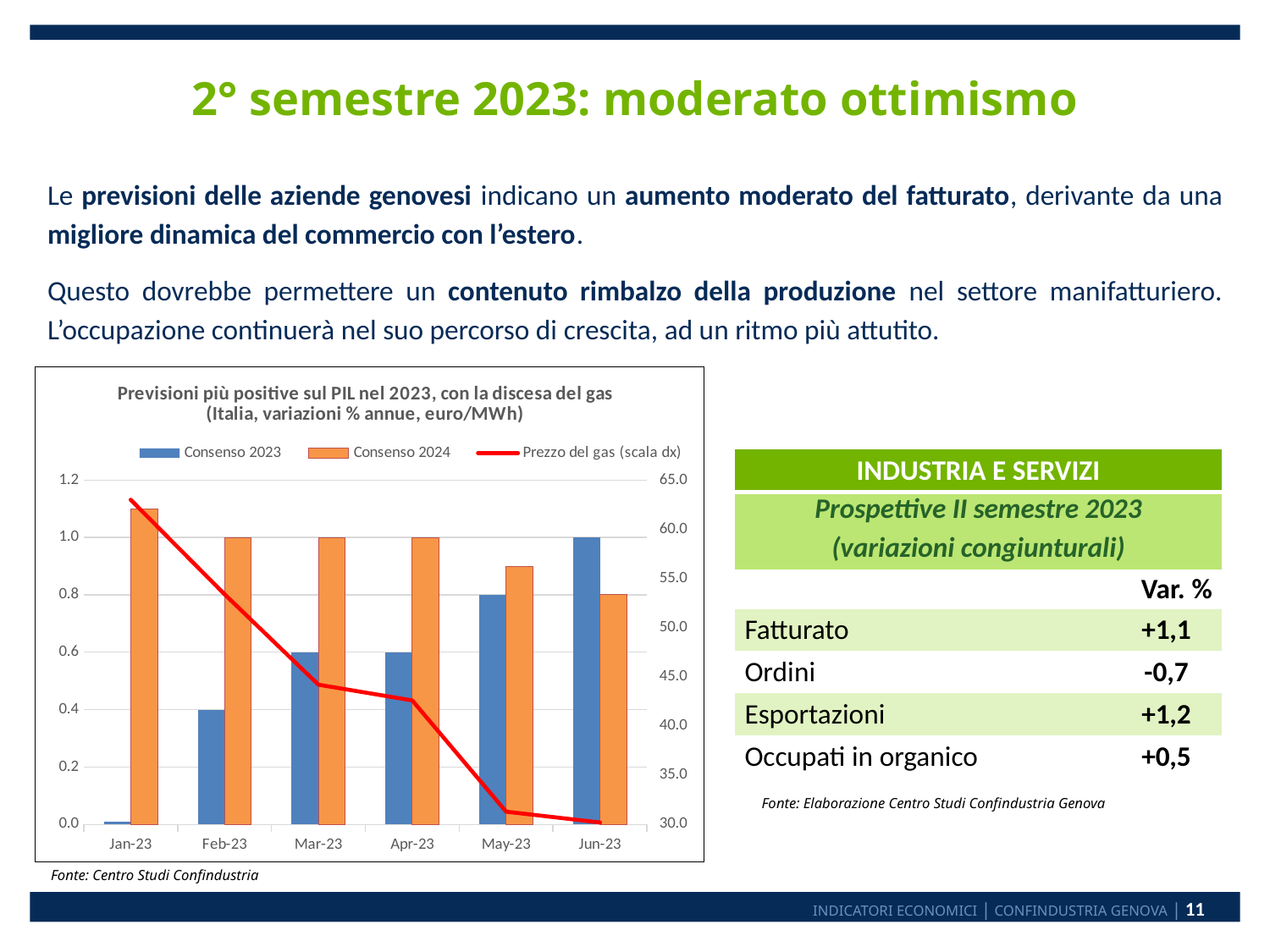
How many months are shown on the x axis of the chart? 6 In which month is the Consenso 2023 bar highest? Jun-23 In Feb-23, which is larger: Consenso 2023 or Consenso 2024? Consenso 2024 In which month is the Consenso 2023 bar lowest? Jan-23 Does the Consenso 2023 series rise or fall from Jan-23 to Jun-23? rise What kind of chart is shown on the slide? bar chart with a line How many series does the chart legend list? 3 Does the Prezzo del gas line rise or fall from Jan-23 to Jun-23? fall Is the Prezzo del gas value for Jan-23 greater or less than 60.0? greater What is the Consenso 2023 value for Jun-23? 1.0 In which month is the Consenso 2024 bar highest? Jan-23 Is the Prezzo del gas value for Jun-23 greater or less than 35.0? less